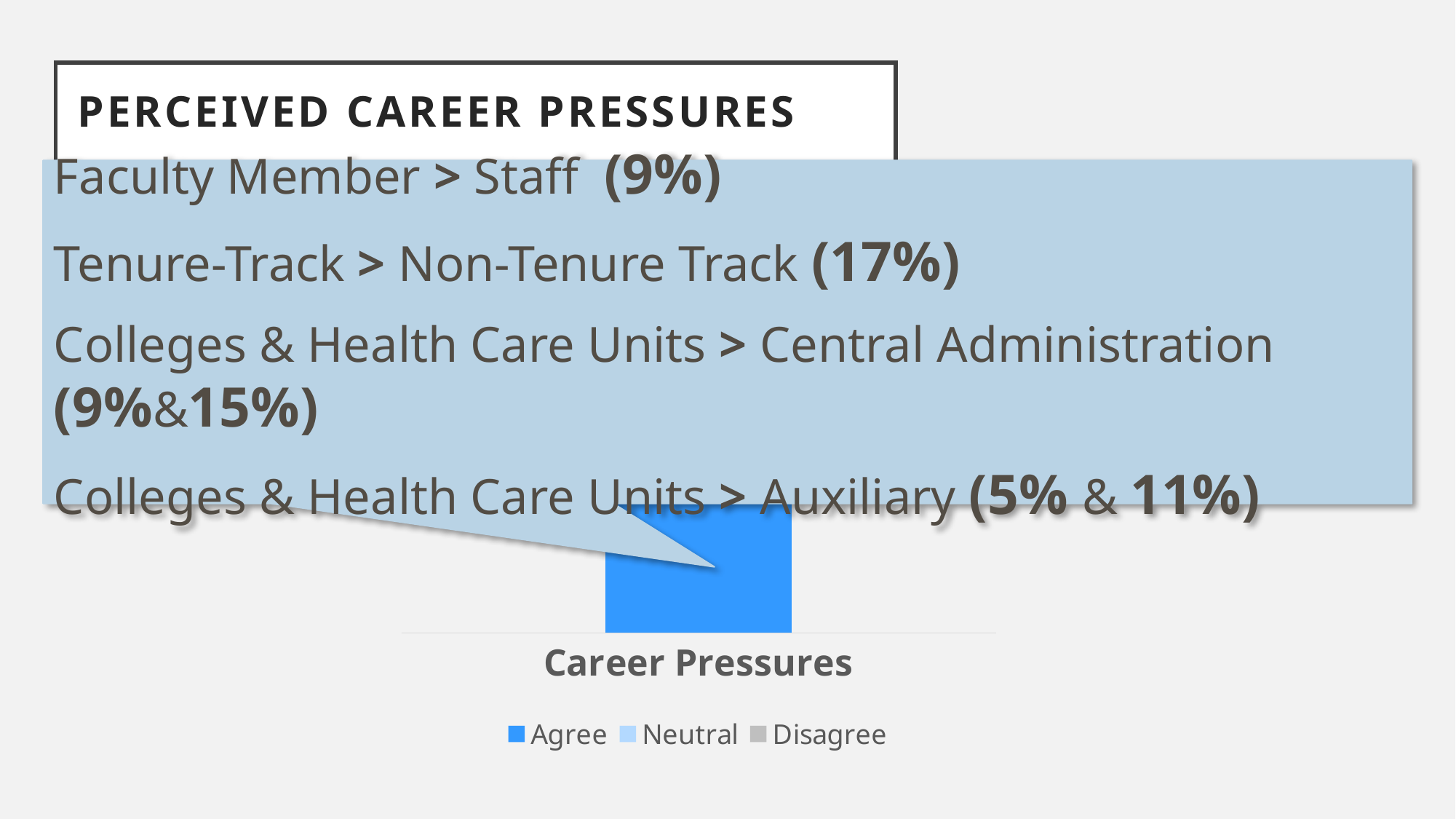
What are the three series named in the chart legend? Agree, Neutral, Disagree What is the category label shown on the x axis of the chart? Career Pressures What kind of chart is shown on the slide? bar chart How many series does the chart legend list? 3 Which series in the legend is shown in dark blue? Agree How many category labels are visible on the x axis of the chart? 1